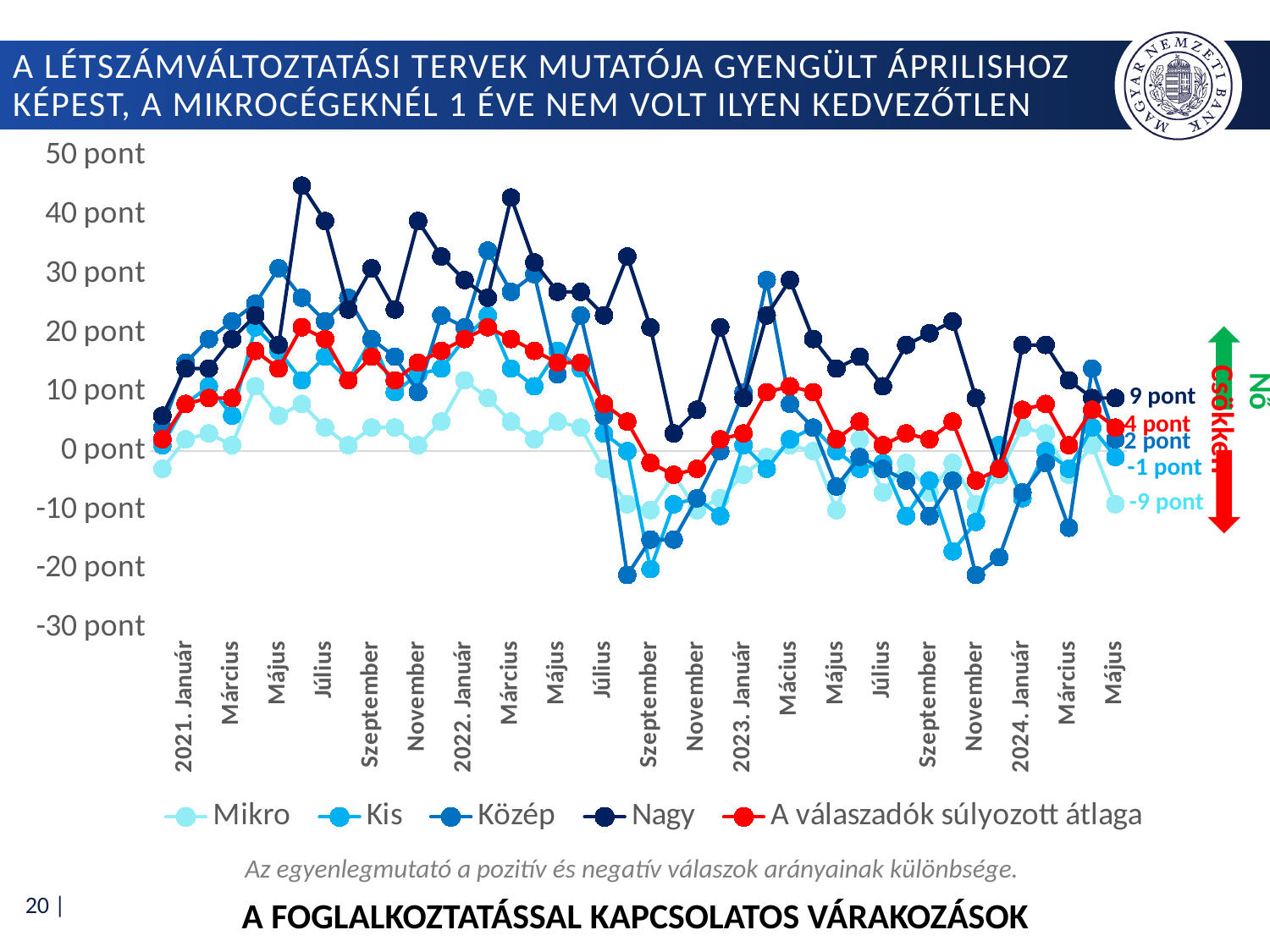
What type of chart is shown on the slide? line chart What is the final labelled value for 'A válaszadók súlyozott átlaga'? 4 pont What is the final labelled value for the Mikro series? -9 pont Is the value for Nagy in 2021. Január greater or less than 10 pont? greater At the end of the chart, which has the larger labelled value: Közép or Kis? Közép What is the final labelled value for the Nagy series? 9 pont What is the final labelled value for the Kis series? -1 pont How many series does the legend list? 5 Which series has the lowest labelled value at the end of the chart? Mikro Which series has the highest labelled value at the end of the chart? Nagy Which colour is used for the 'A válaszadók súlyozott átlaga' line? red What is the difference between the final labelled values of Nagy and Mikro? 18 pont